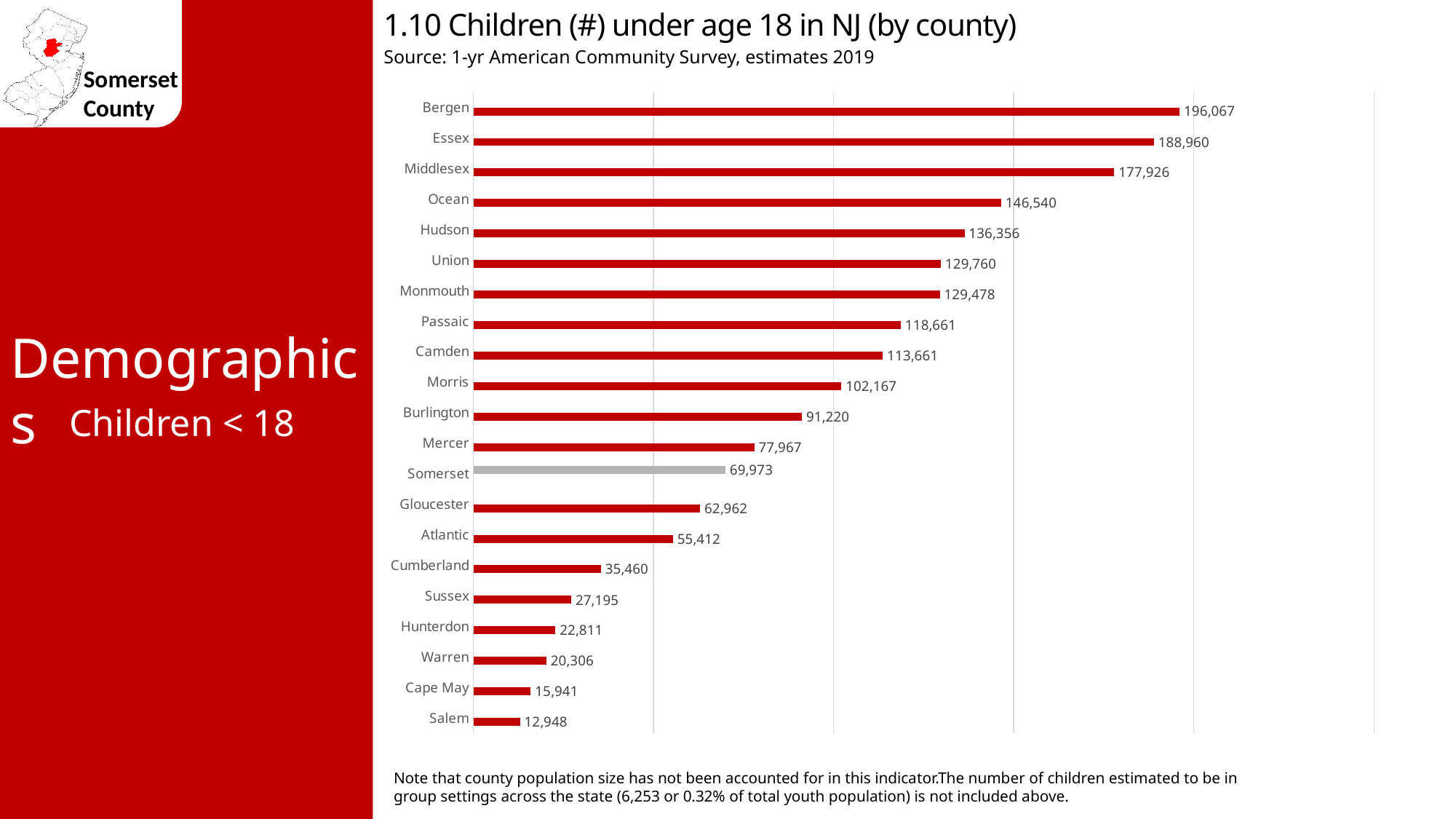
What is the number of children under age 18 in Bergen County? 196,067 How many children under 18 are shown for Cape May? 15,941 What is the difference between the values for Somerset and Gloucester? 7,011 Which has a larger value, Mercer or Burlington? Burlington Which county has the lowest number of children under age 18? Salem Which has a larger value, Ocean or Hudson? Ocean What is the value shown for Somerset County? 69,973 Which county has the highest number of children under age 18? Bergen What is the difference between the values for Bergen and Essex? 7,107 What type of chart is used on this slide? Bar chart Which county's bar is shown in grey instead of red? Somerset How many counties are shown in the chart? 21